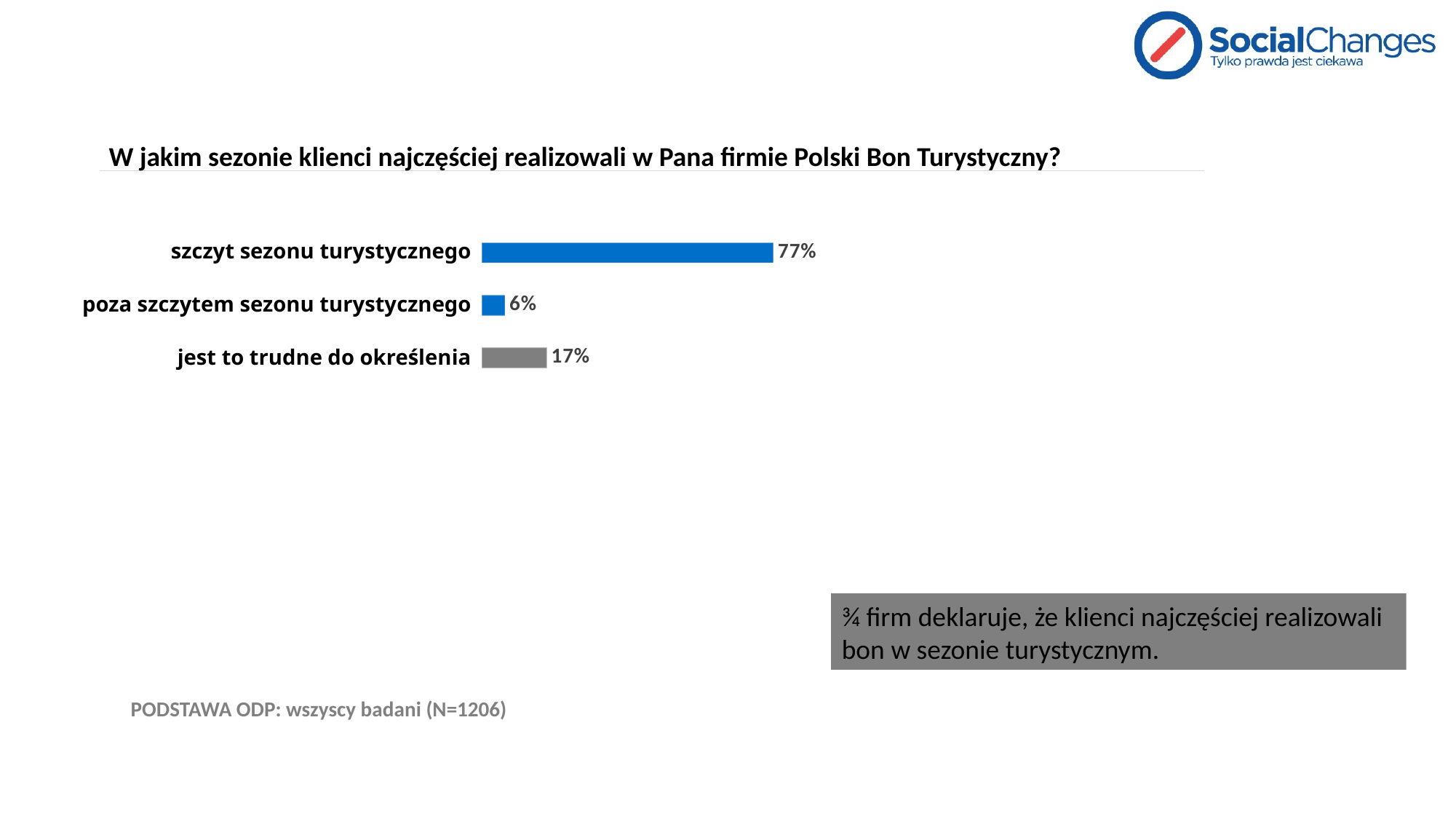
What is the difference between the values for "szczyt sezonu turystycznego" and "jest to trudne do określenia"? 60% What kind of chart is shown on the slide? bar chart What is the value for "poza szczytem sezonu turystycznego"? 6% What is the sample size (N) stated at the bottom of the slide? N=1206 What is the value for "szczyt sezonu turystycznego"? 77% Which category has the highest value? szczyt sezonu turystycznego Which category has the lowest value? poza szczytem sezonu turystycznego What is the value for "jest to trudne do określenia"? 17% Which is larger: the value for "jest to trudne do określenia" or for "poza szczytem sezonu turystycznego"? jest to trudne do określenia How many categories are shown in the chart? 3 What colour is the bar for "jest to trudne do określenia"? grey What is the difference between the values for "jest to trudne do określenia" and "poza szczytem sezonu turystycznego"? 11%